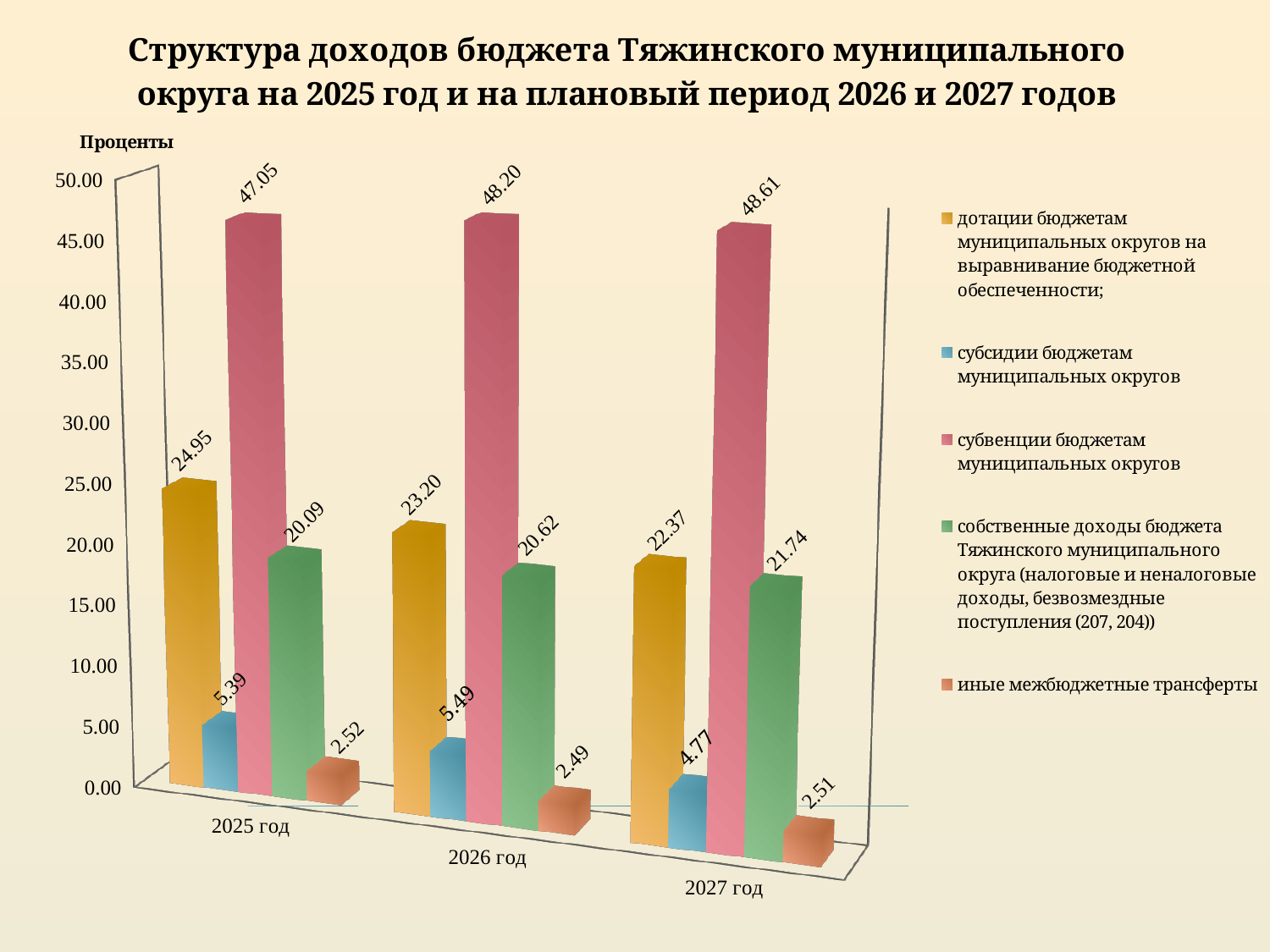
What is the value for собственные доходы бюджета Тяжинского муниципального округа in 2026 год? 20.62 How many series does the legend list? 5 What is the difference between the дотации values for 2025 год and 2027 год? 2.58 Which is larger in 2026 год: субсидии бюджетам муниципальных округов or иные межбюджетные трансферты? субсидии бюджетам муниципальных округов What is the value for субвенции бюджетам муниципальных округов in 2025 год? 47.05 What kind of chart is shown on the slide? bar chart What is the value for иные межбюджетные трансферты in 2025 год? 2.52 What is the value for дотации бюджетам муниципальных округов на выравнивание бюджетной обеспеченности in 2027 год? 22.37 In which year is the value for субвенции бюджетам муниципальных округов the highest? 2027 год In which year is the value for субсидии бюджетам муниципальных округов the lowest? 2027 год Do the values for дотации бюджетам муниципальных округов на выравнивание бюджетной обеспеченности rise or fall from 2025 год to 2027 год? fall How many years (categories) are shown on the x axis? 3